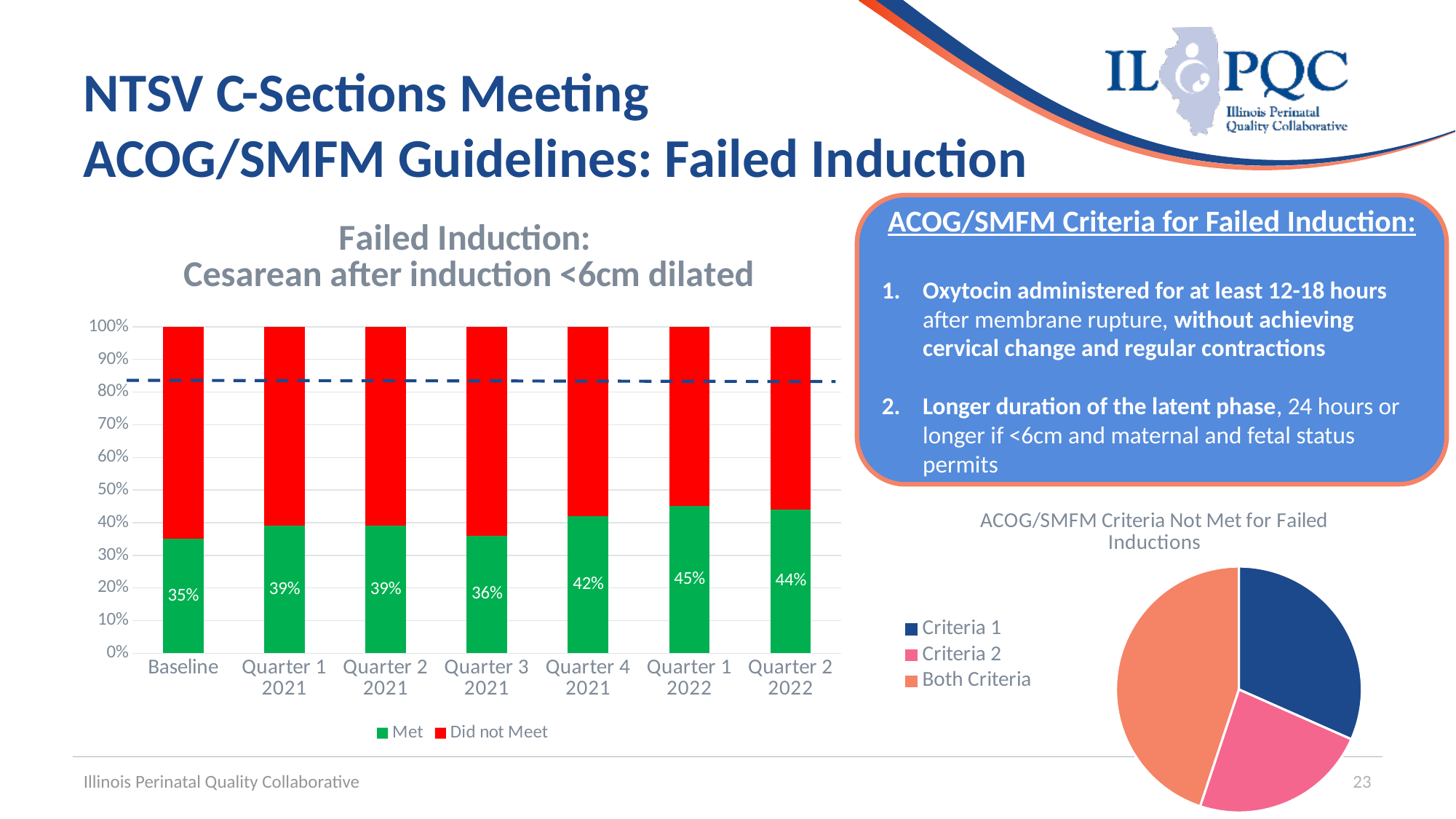
In the 'Failed Induction: Cesarean after induction <6cm dilated' chart, what is the difference in Met percentage between Quarter 1 2022 and Baseline? 10 percentage points In the 'Failed Induction: Cesarean after induction <6cm dilated' chart, which period has the highest Met percentage? Quarter 1 2022 In the 'Failed Induction: Cesarean after induction <6cm dilated' chart, what is the Met value for Quarter 4 2021? 42% In the 'Failed Induction: Cesarean after induction <6cm dilated' chart, what is the Met value for Quarter 2 2022? 44% In the 'Failed Induction: Cesarean after induction <6cm dilated' chart, which period has the lowest Met percentage? Baseline In the 'ACOG/SMFM Criteria Not Met for Failed Inductions' pie chart, which category has the largest slice? Both Criteria What kind of chart is the 'ACOG/SMFM Criteria Not Met for Failed Inductions' chart? Pie chart In the 'Failed Induction: Cesarean after induction <6cm dilated' chart, what is the Met value for Baseline? 35% How many time periods are shown on the x axis of the 'Failed Induction: Cesarean after induction <6cm dilated' chart? 7 How many series does the legend of the 'Failed Induction: Cesarean after induction <6cm dilated' chart list? 2 In the 'Failed Induction: Cesarean after induction <6cm dilated' chart, is the Did not Meet portion for Baseline greater or less than 60%? greater In the 'Failed Induction: Cesarean after induction <6cm dilated' chart, which has a higher Met percentage, Quarter 3 2021 or Quarter 4 2021? Quarter 4 2021